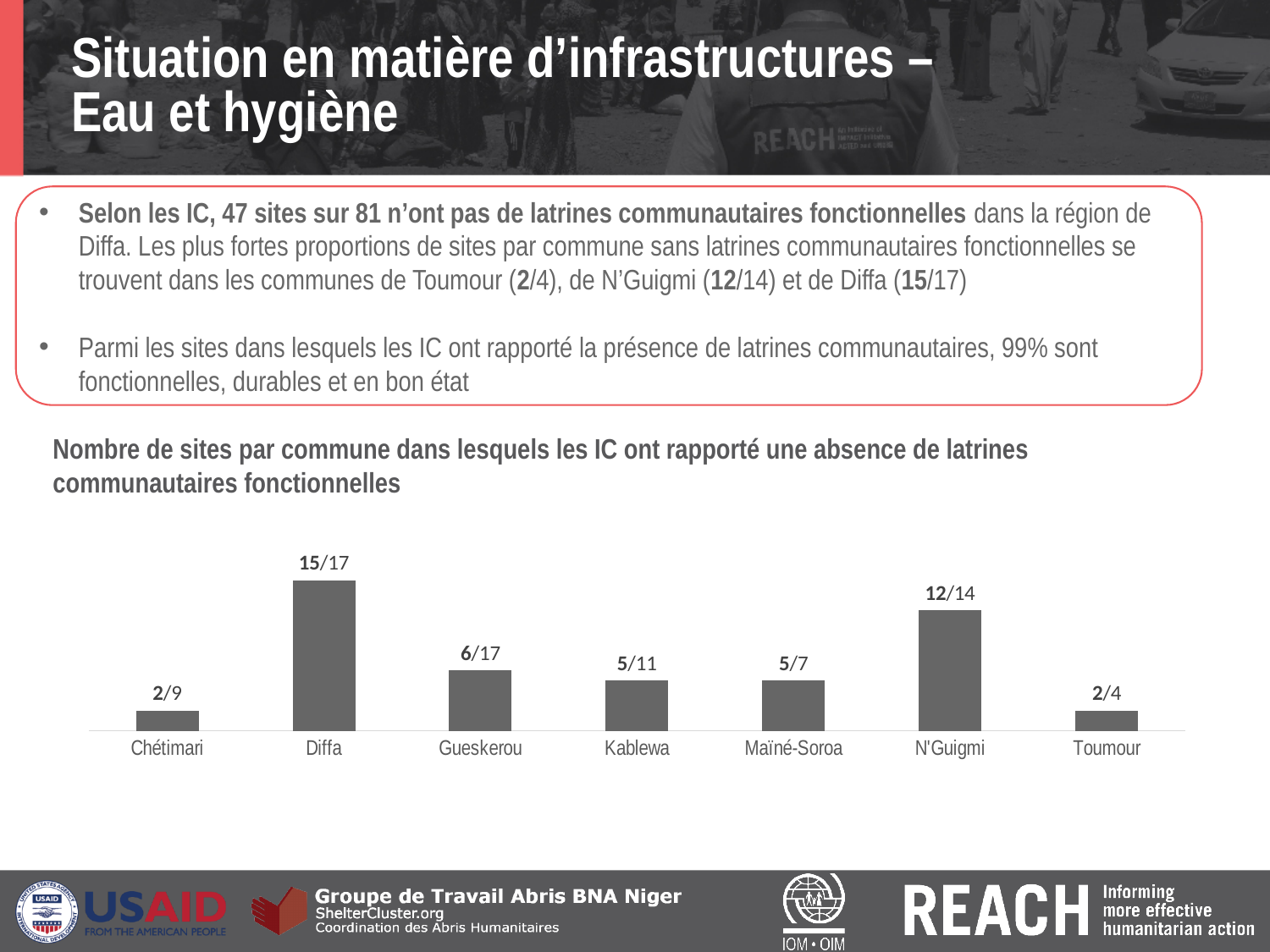
How many more sites without functional communal latrines does Diffa have than N'Guigmi? 3 What is the data label shown for Diffa in the chart? 15/17 What is the data label shown for Toumour in the chart? 2/4 What is the data label shown for N'Guigmi in the chart? 12/14 What type of chart is shown on the slide? Bar chart How many communes are shown on the x axis of the chart? 7 Which commune has the taller bar, Diffa or N'Guigmi? Diffa Which commune has the taller bar, Gueskerou or Chétimari? Gueskerou What is the data label shown for Chétimari in the chart? 2/9 Which commune has the highest number of sites without functional communal latrines in the chart? Diffa What is the title of the chart on the slide? Nombre de sites par commune dans lesquels les IC ont rapporté une absence de latrines communautaires fonctionnelles What is the data label shown for Maïné-Soroa in the chart? 5/7